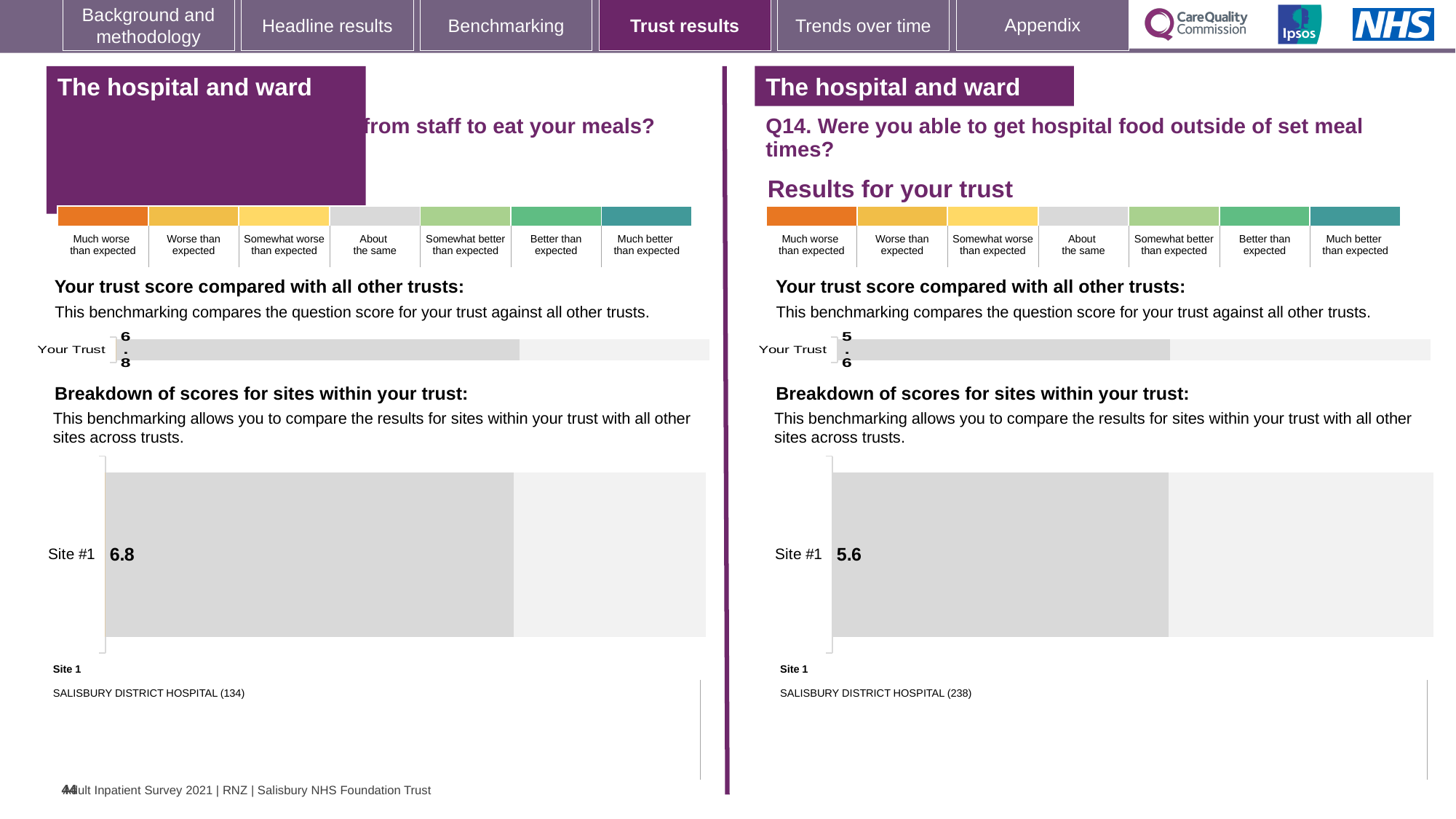
In the 'Breakdown of scores for sites within your trust' chart on the left-hand side of the slide, what is the score for Site #1? 6.8 What type of chart is used to show the Site #1 score in the right-hand (Q14) 'Breakdown of scores for sites within your trust' section? Bar chart How many sites are plotted in the 'Breakdown of scores for sites within your trust' chart on the right-hand side of the slide (Q14)? 1 Which is larger: the Site #1 score in the left-hand breakdown chart or the Site #1 score in the right-hand (Q14) breakdown chart? Left-hand chart (6.8) On the right-hand side of the slide (Q14), what is the score shown for Your Trust in the 'Your trust score compared with all other trusts' chart? 5.6 On the left-hand side of the slide, what is the score shown for Your Trust in the 'Your trust score compared with all other trusts' chart? 6.8 How many sites are plotted in the 'Breakdown of scores for sites within your trust' chart on the left-hand side of the slide? 1 In the 'Breakdown of scores for sites within your trust' chart on the right-hand side of the slide (Q14), what is the score for Site #1? 5.6 Which site is listed as Site 1 beneath the right-hand (Q14) breakdown chart? SALISBURY DISTRICT HOSPITAL (238) Which site is listed as Site 1 beneath the left-hand breakdown chart? SALISBURY DISTRICT HOSPITAL (134) What type of chart is used to show the Your Trust score on the left-hand side of the slide? Bar chart What is the difference between the Site #1 score on the left-hand breakdown chart (6.8) and the Site #1 score on the right-hand Q14 breakdown chart (5.6)? 1.2